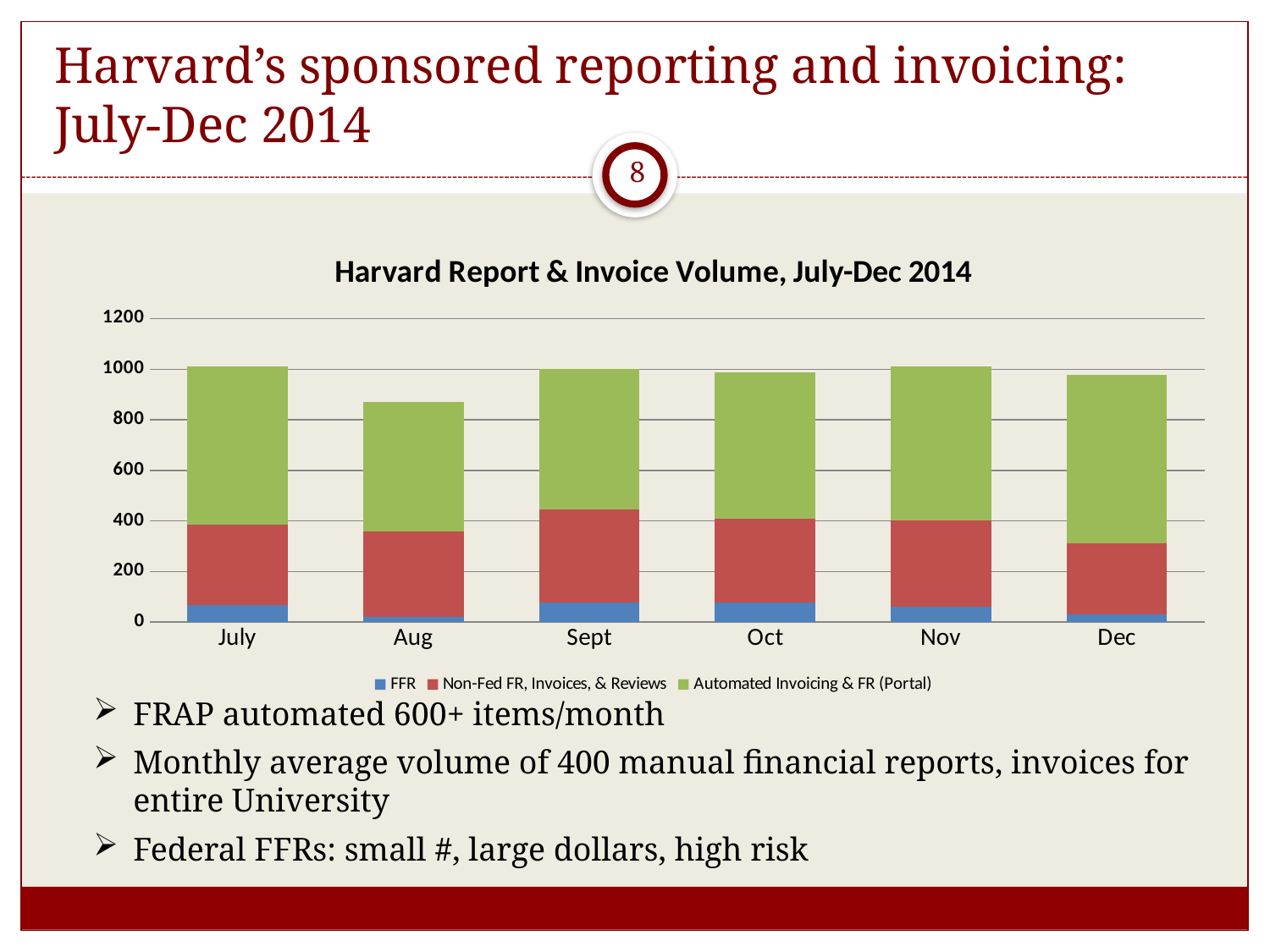
Which month has the larger total stacked bar, Aug or Dec? Dec Which month has the lowest total stacked bar? Aug What is the title of the chart? Harvard Report & Invoice Volume, July-Dec 2014 What kind of chart is shown on the slide? stacked bar chart Which series is shown in green in the chart? Automated Invoicing & FR (Portal) Is the total stacked bar for Aug greater or less than 800? greater Is the total stacked bar for Aug greater or less than 1000? less Is the FFR value for Aug greater or less than 200? less How many months are shown on the x axis of the chart? 6 Which month has the larger total stacked bar, Aug or Sept? Sept How many series does the chart legend list? 3